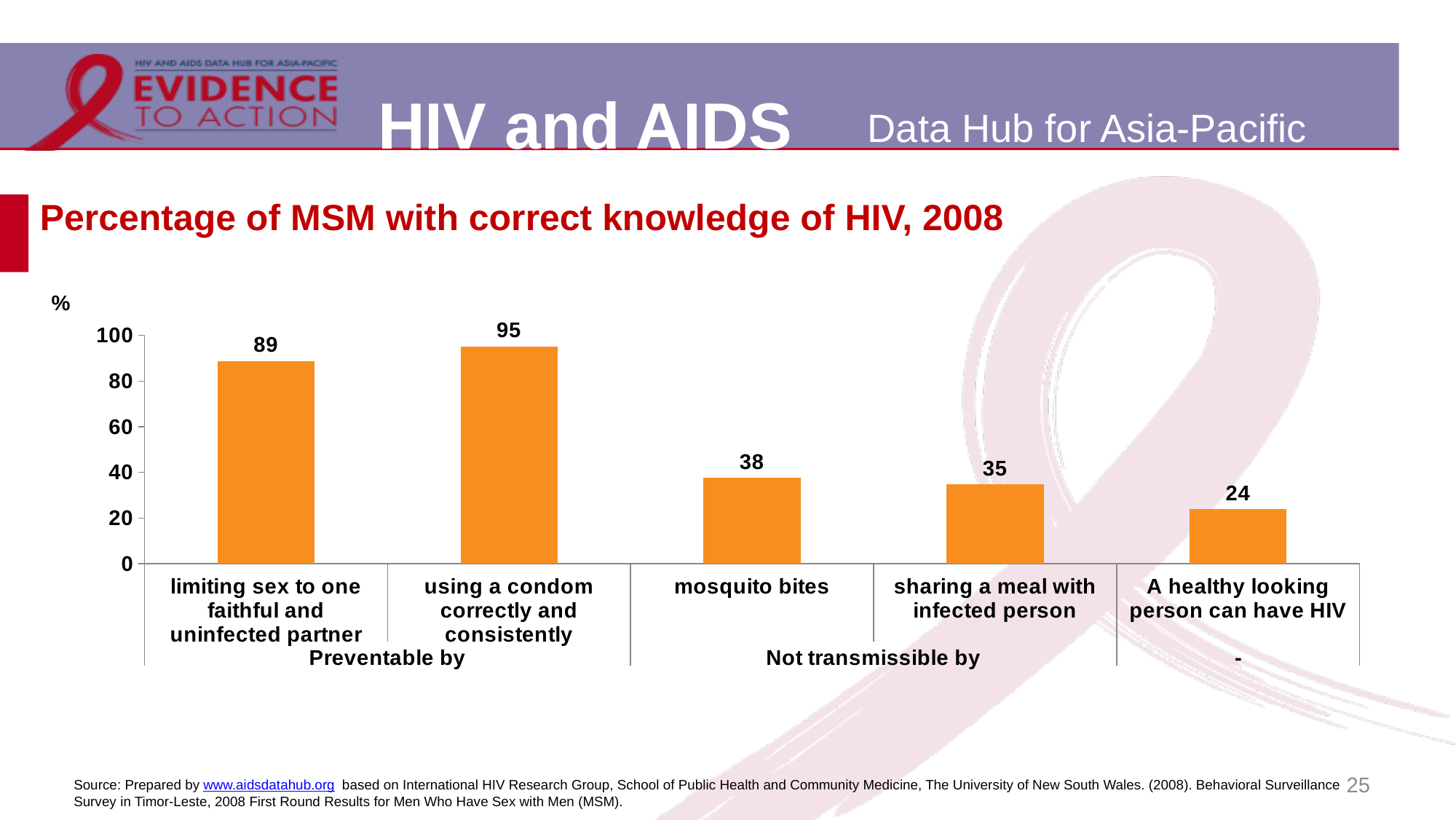
Which category has the lowest value? A healthy looking person can have HIV What is the value for 'using a condom correctly and consistently'? 95 What is the value for 'mosquito bites'? 38 What is the value for 'A healthy looking person can have HIV'? 24 Which group label covers the categories 'mosquito bites' and 'sharing a meal with infected person'? Not transmissible by Which is larger, the value for 'limiting sex to one faithful and uninfected partner' or the value for 'sharing a meal with infected person'? limiting sex to one faithful and uninfected partner How many categories are shown in the chart? 5 What is the difference between the values for 'mosquito bites' and 'sharing a meal with infected person'? 3 Which category has the highest value? using a condom correctly and consistently What is the difference between the values for 'using a condom correctly and consistently' and 'limiting sex to one faithful and uninfected partner'? 6 What is the title of the chart? Percentage of MSM with correct knowledge of HIV, 2008 What kind of chart is shown on the slide? bar chart